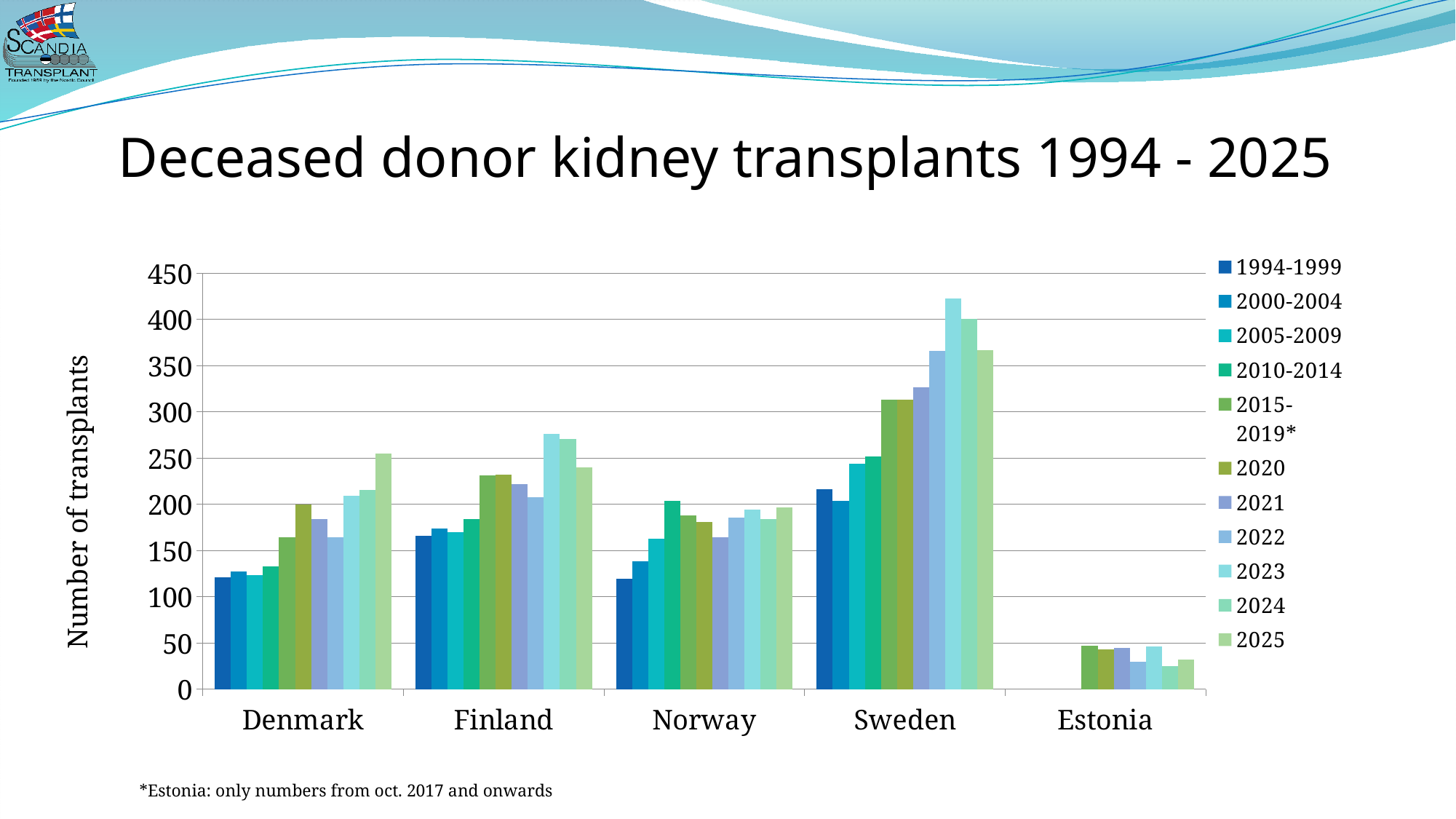
Is the value for Estonia in 2024 greater or less than 50? less How many countries are shown on the x axis? 5 Which is larger for 2023: Finland or Norway? Finland How many series does the legend list? 11 What kind of chart is shown on the slide? Bar chart Is the value for Denmark in 2025 greater or less than 200? greater Which country has the lowest value for 2025? Estonia Is the value for Sweden in 2023 greater or less than 400? greater What is the label on the y axis? Number of transplants Which country has the highest value for 2023? Sweden For Sweden, which is larger: the 2023 value or the 2024 value? 2023